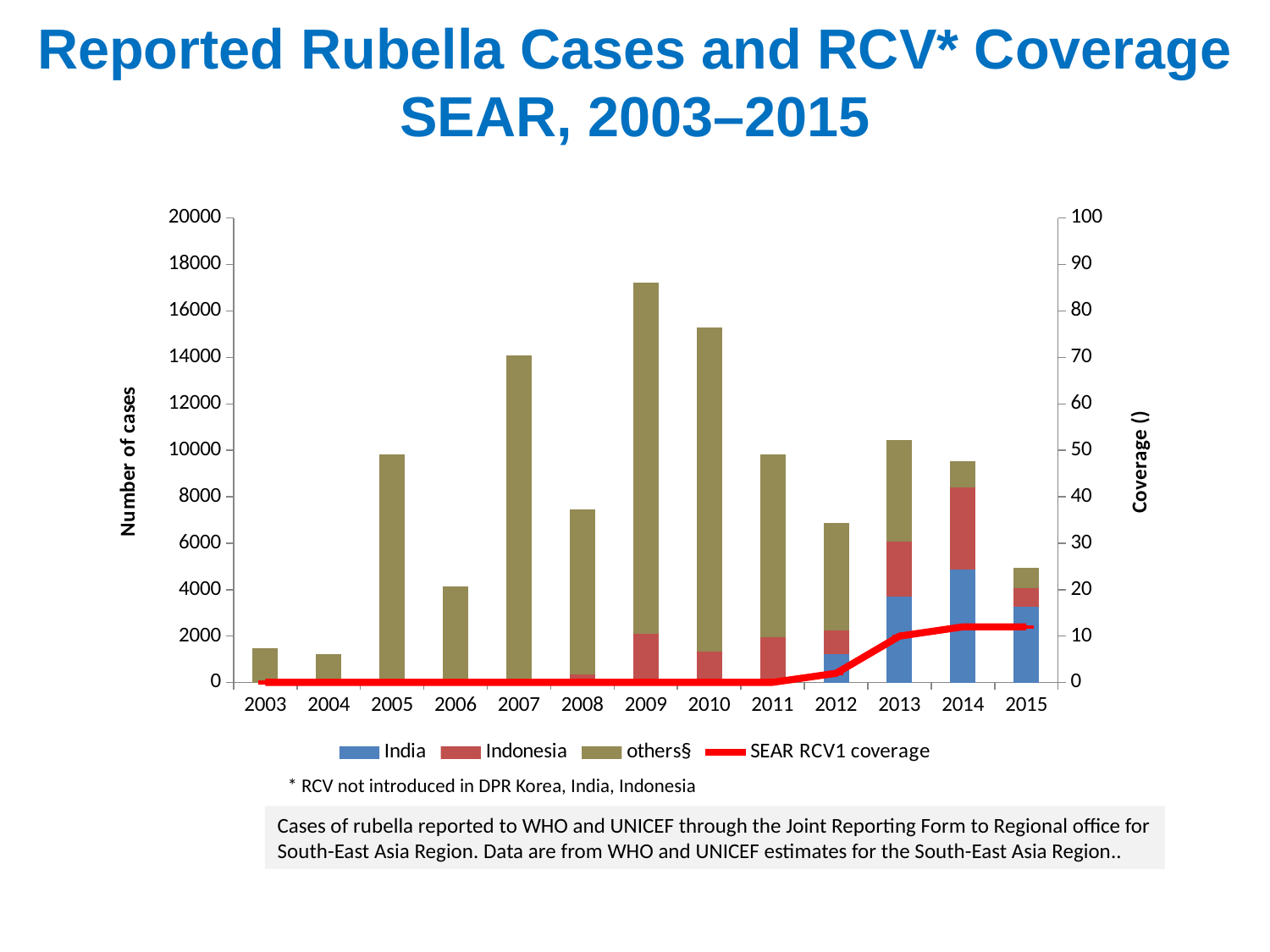
What kind of chart is used to show the number of cases? Stacked bar chart (with a line for coverage) How many years are shown on the x axis? 13 Does the SEAR RCV1 coverage line rise or fall from 2012 to 2014? rise Which year has more total reported cases, 2010 or 2011? 2010 Which year has more total reported cases, 2005 or 2007? 2007 Is the total number of cases in 2015 greater or less than 6000? less Is the total number of cases in 2009 greater or less than 16000? greater How many series does the legend list? 4 Is the total number of cases in 2012 greater or less than 6000? greater Which year has the highest total number of reported rubella cases? 2009